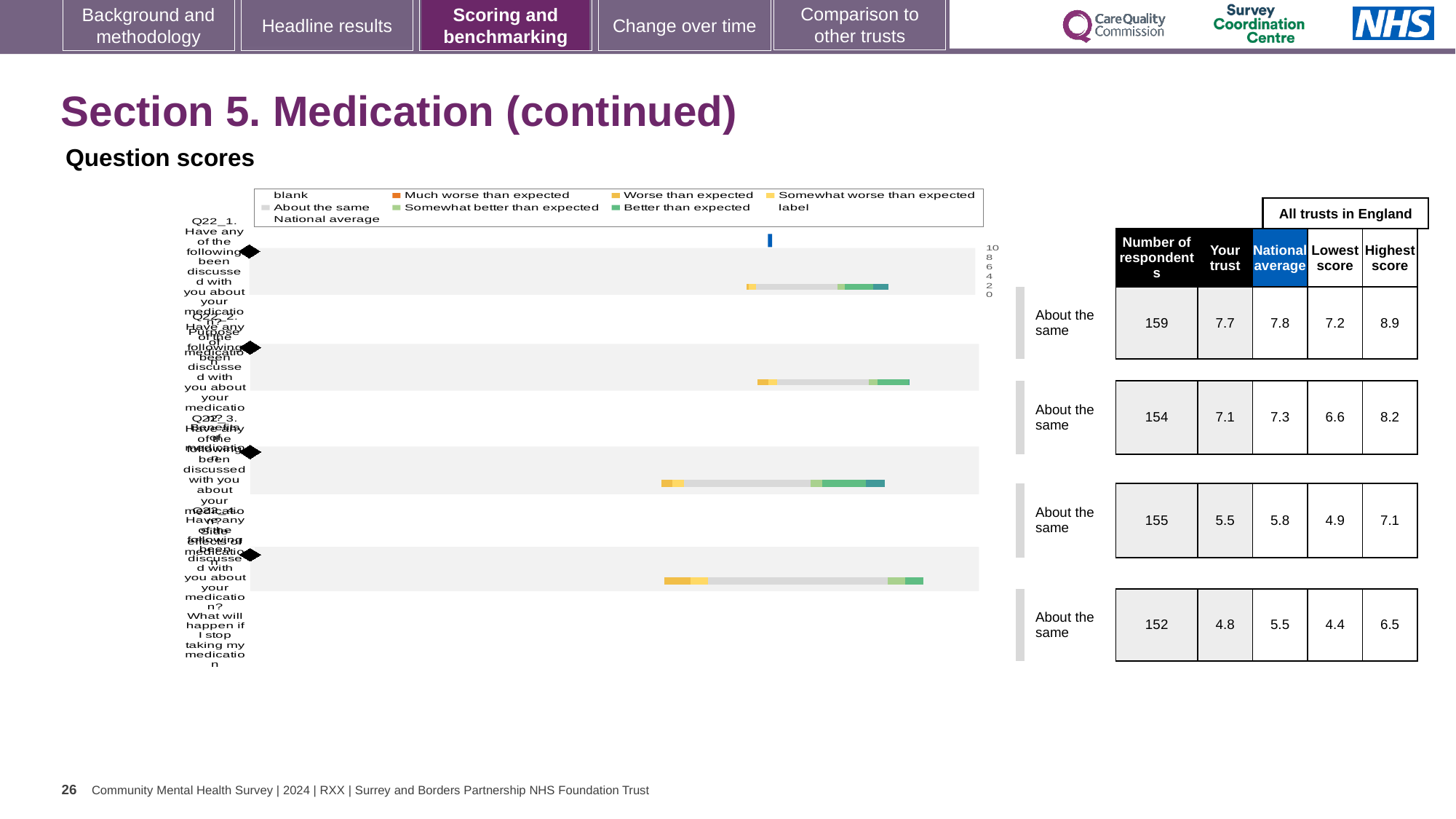
In the table, what is the 'Your trust' score for the second question row (Q22_2)? 7.1 In the table, what is the highest score for the fourth question row (Q22_4, 'What will happen if I stop taking my medication')? 6.5 Which question row has the highest 'Your trust' score in the table? Q22_1 For the first question row (Q22_1), which is larger: the 'Your trust' score or the national average? National average In the table, what is the national average for the third question row (Q22_3)? 5.8 What benchmark category is shown next to every question row on the slide? About the same Which question row has the lowest number of respondents in the table? Q22_4 How many question rows (bars) does the chart show? 4 In the table, what is the number of respondents for the first question row (Q22_1)? 159 What kind of chart is shown on the left of the slide? bar chart What is the maximum value shown on the chart's score axis? 10 What is the difference between the national average and the 'Your trust' score for the fourth question row (Q22_4)? 0.7